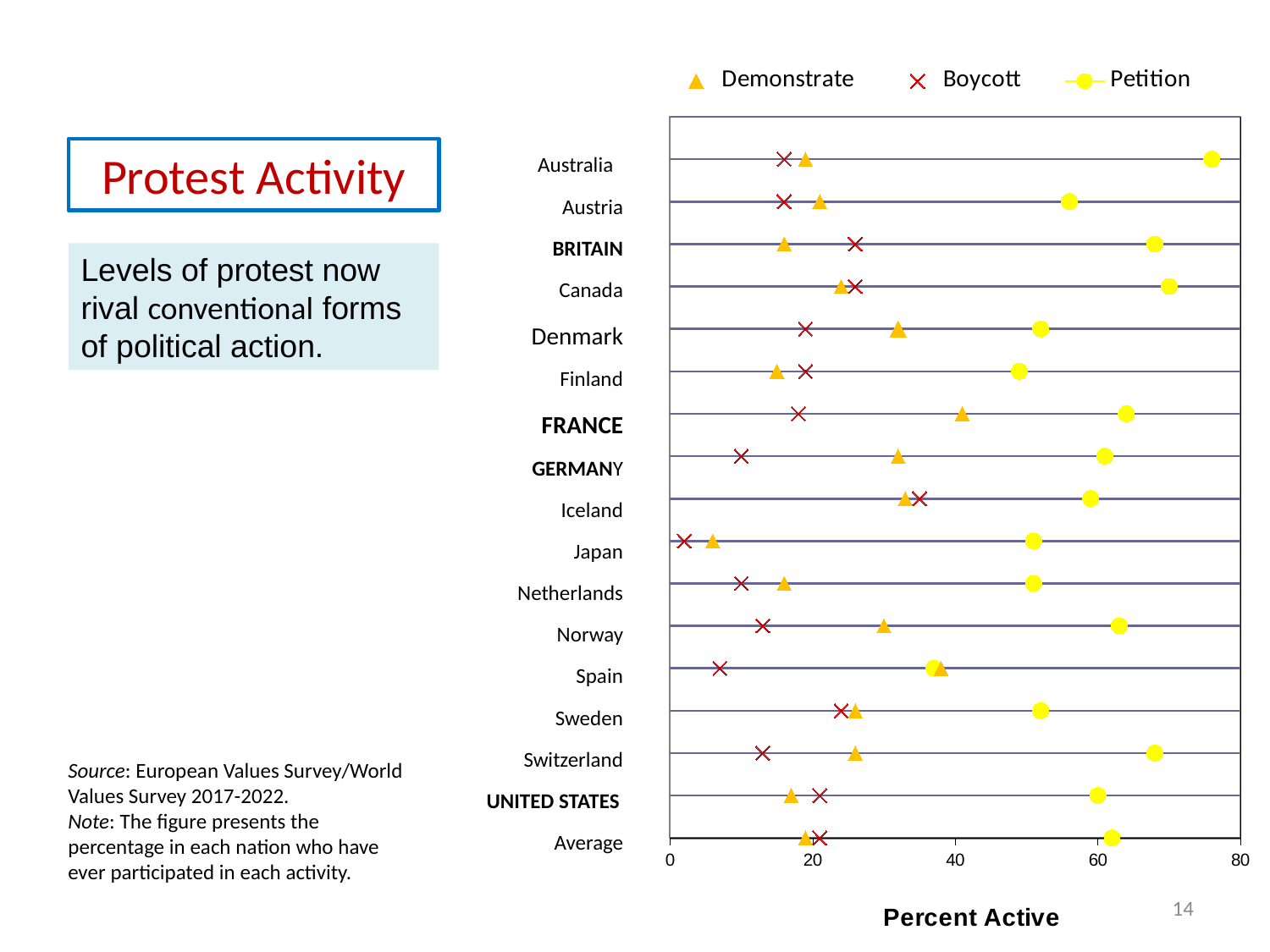
Is the Boycott value for Spain greater or less than 20? less How many countries (including Average) are listed on the vertical axis? 17 Which country has the lowest Petition value? Spain How many series does the legend list? 3 Which is larger for Japan, the Demonstrate value or the Petition value? Petition What is the title of the horizontal axis? Percent Active Is the Petition value for Australia greater or less than 60? greater Which country has the highest Petition value? Australia Which country has the lowest Boycott value? Japan Is the Demonstrate value for France greater or less than 20? greater Which country has the highest Boycott value? Iceland What kind of chart is shown on the slide? dot plot